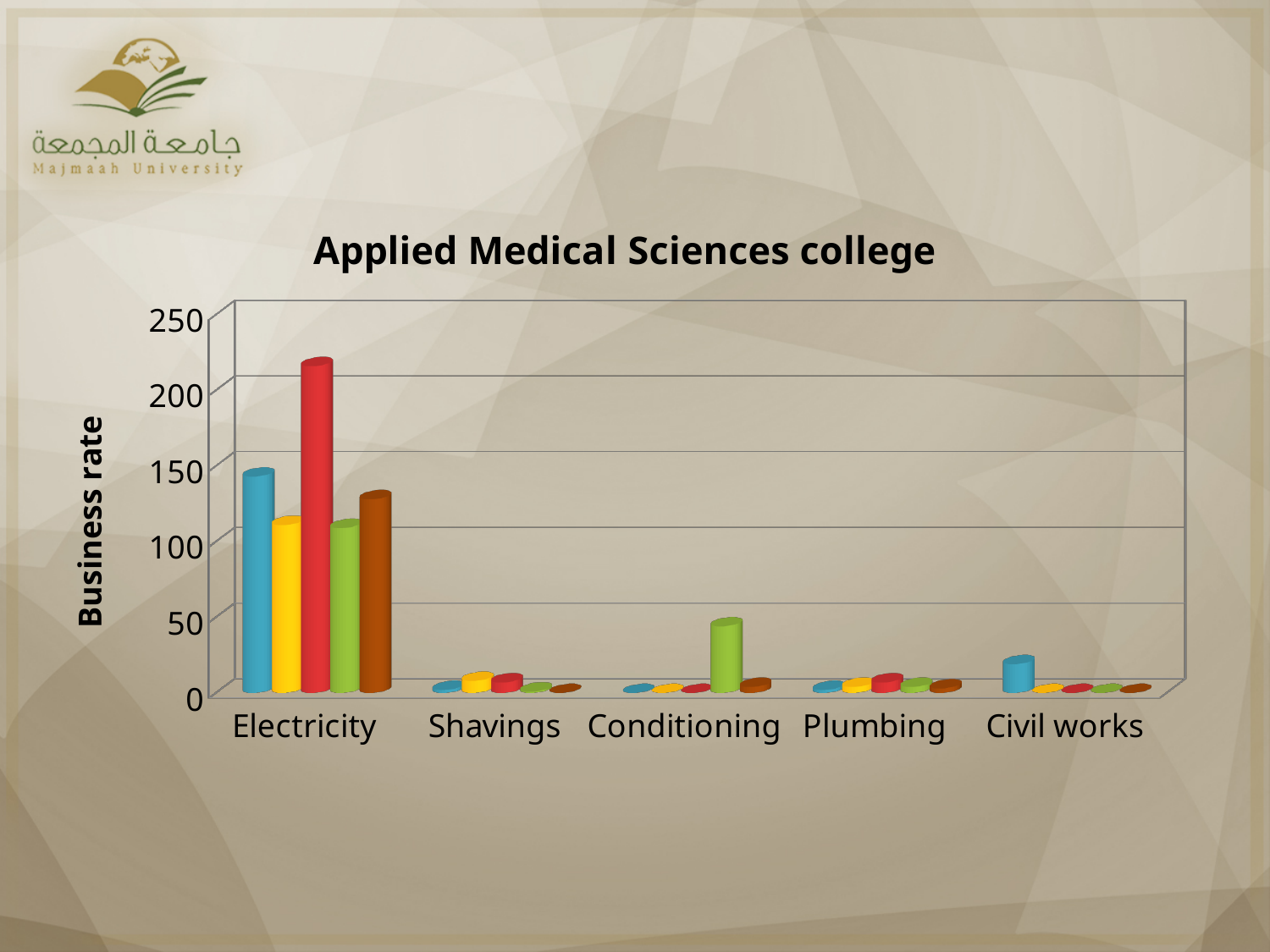
How many categories are shown on the x axis of the chart? 5 Which is larger: the green bar for Conditioning or the green bar for Plumbing? the green bar for Conditioning Which category has the tallest bar in the chart? Electricity Is the value of the red bar for Electricity greater or less than 200? greater Is the value of the blue bar for Civil works greater or less than 50? less Is the value of the blue bar for Electricity greater or less than 100? greater What type of chart is shown on the slide? bar chart What is the title of the chart? Applied Medical Sciences college What is the label on the vertical axis of the chart? Business rate Which is larger: the red bar for Electricity or the green bar for Conditioning? the red bar for Electricity